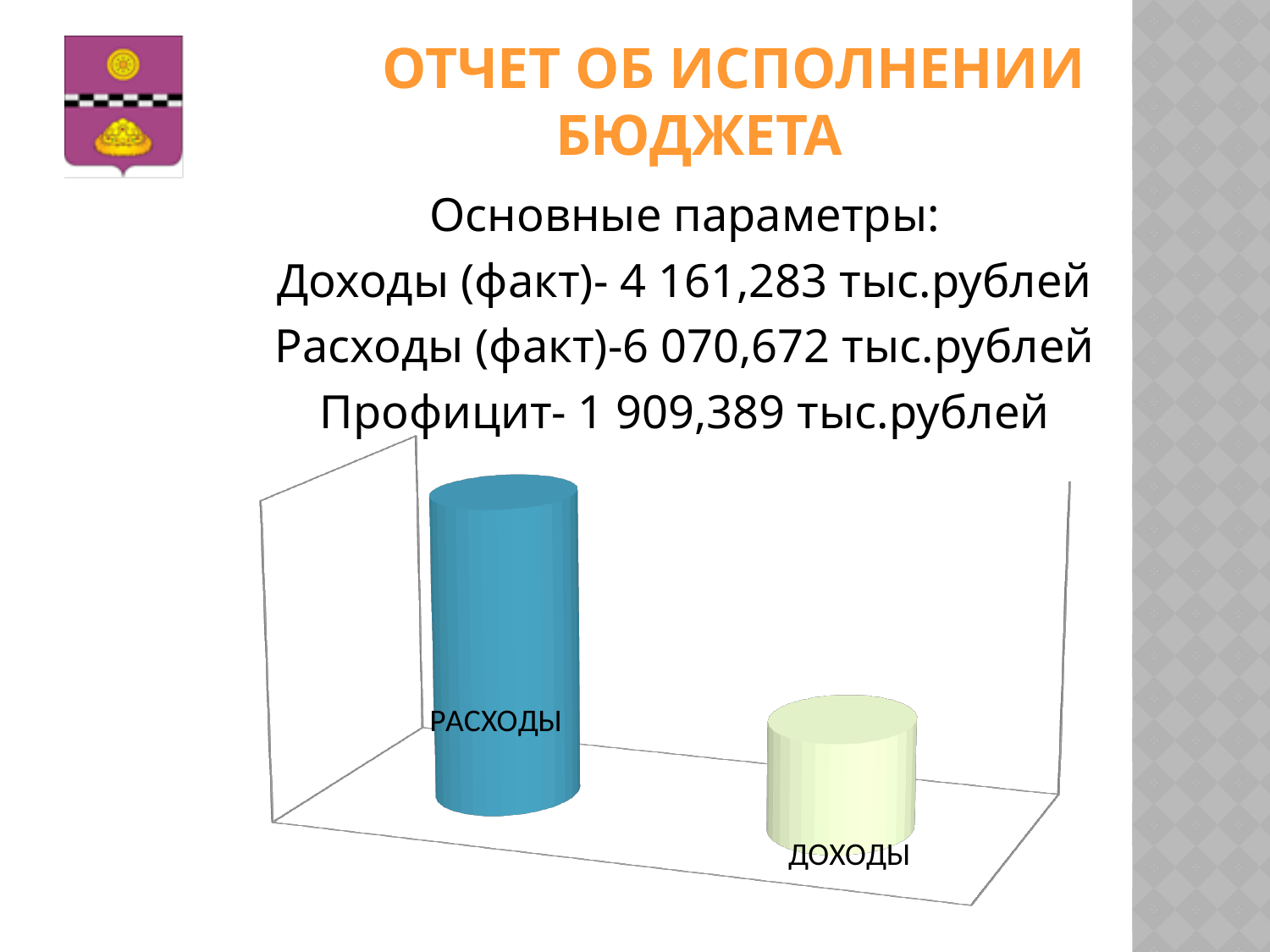
According to the slide, what is the value of Доходы (факт)? 4 161,283 тыс.рублей Which is larger in the chart, РАСХОДЫ or ДОХОДЫ? РАСХОДЫ What is the title of the slide containing the chart? ОТЧЕТ ОБ ИСПОЛНЕНИИ БЮДЖЕТА What kind of chart is shown on the slide? Bar chart Which category has the tallest bar in the chart? РАСХОДЫ Which category has the shortest bar in the chart? ДОХОДЫ According to the slide, what is the value of Расходы (факт)? 6 070,672 тыс.рублей How many categories are plotted in the chart? 2 What is the difference between Расходы (факт) and Доходы (факт) as stated on the slide? 1 909,389 тыс.рублей What colour is the РАСХОДЫ bar in the chart? Blue